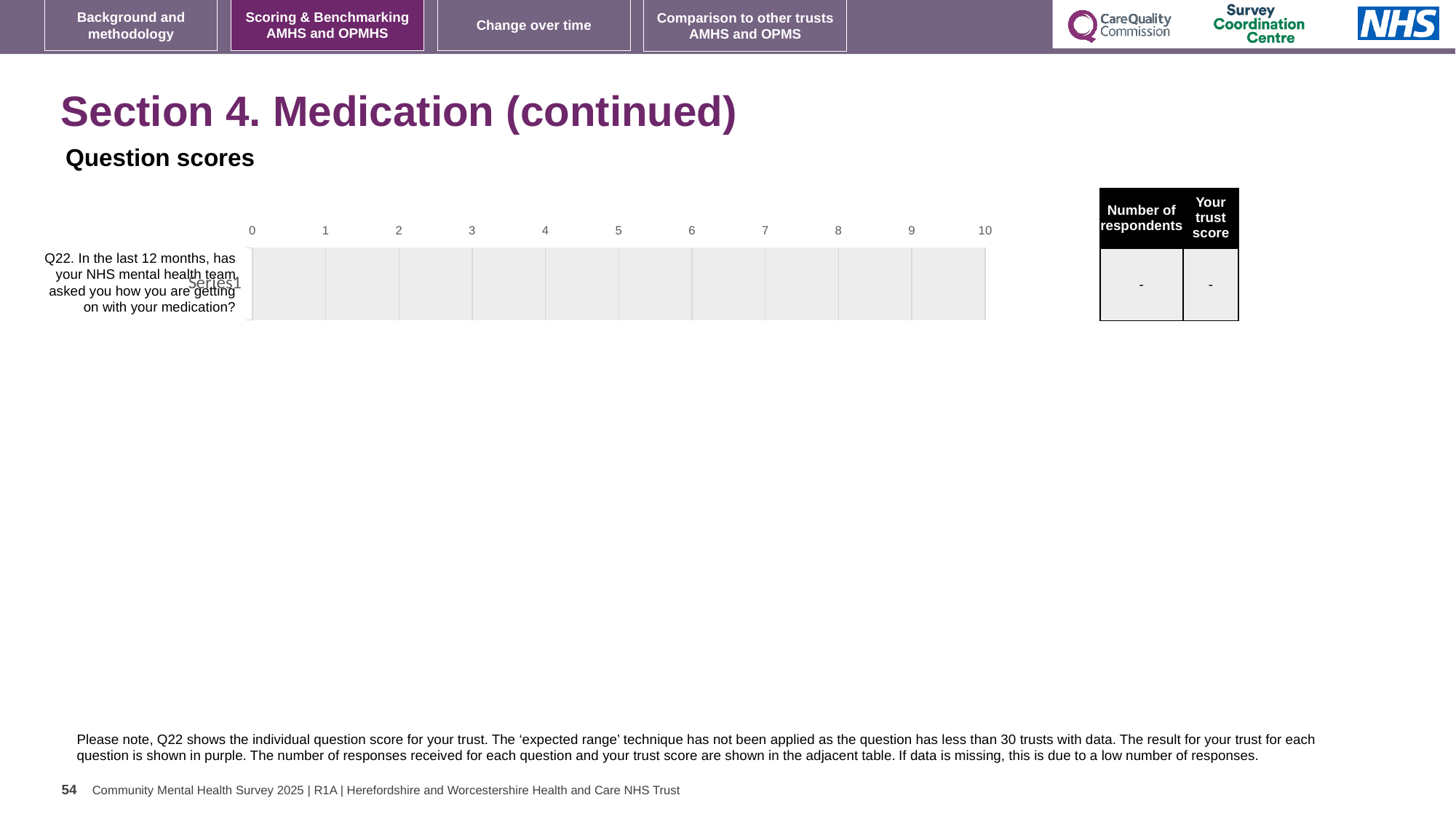
What is the lowest tick value shown on the chart's horizontal axis? 0 What is the highest tick value shown on the chart's horizontal axis? 10 How many questions (categories) are listed on the chart's vertical axis? 1 What kind of chart is shown under 'Question scores'? bar chart Is a bar for the trust score actually plotted for Q22 on the chart? no Which question number is the only category on the chart? Q22